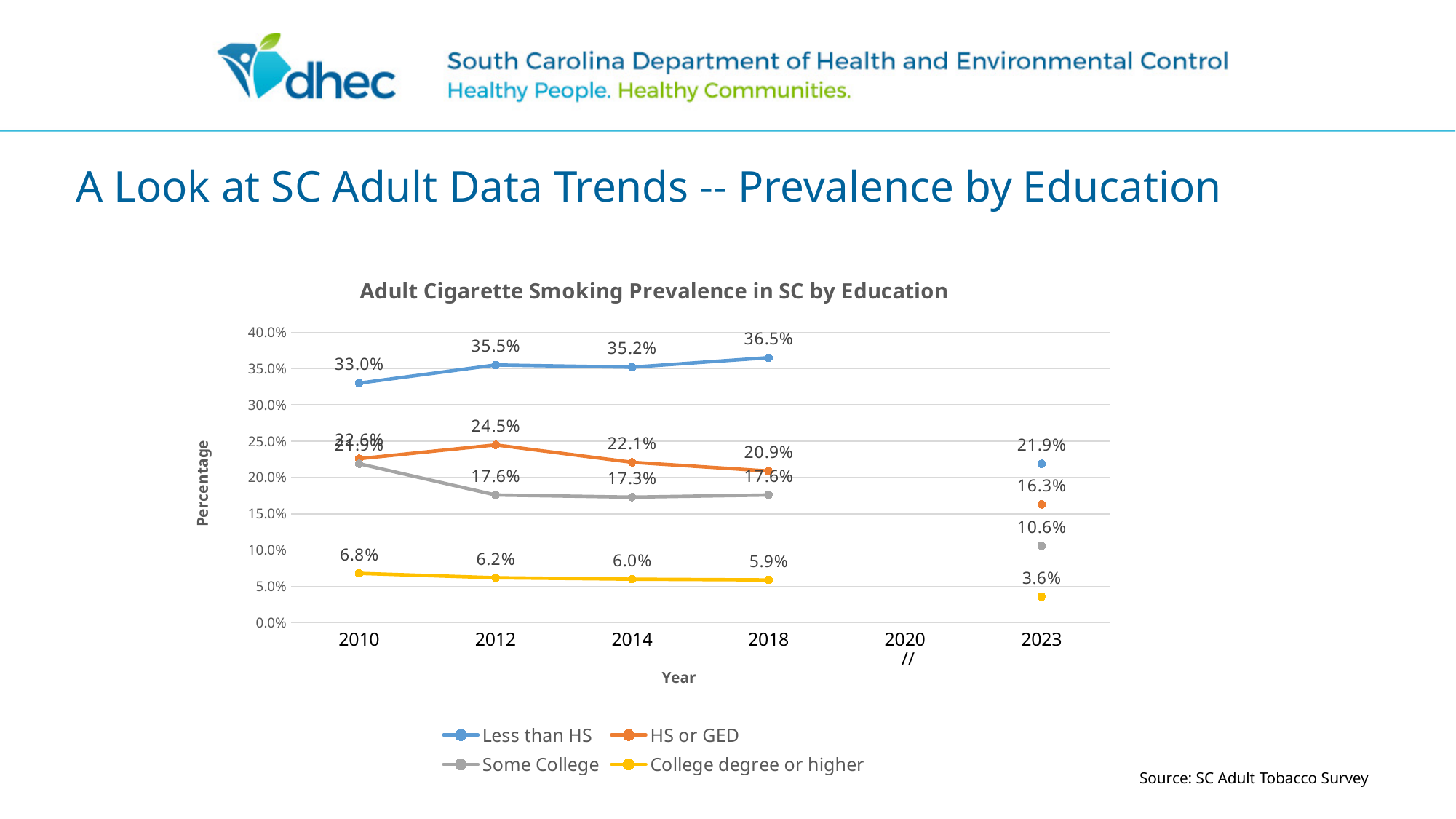
Which is larger in 2018: the HS or GED value or the Some College value? HS or GED Does the College degree or higher series rise or fall from 2010 to 2023? fall What was the smoking prevalence for College degree or higher in 2023? 3.6% In which year was the Less than HS prevalence highest? 2018 What type of chart is shown on the slide? line chart Which education group had the lowest smoking prevalence in 2023? College degree or higher What was the smoking prevalence for Less than HS in 2018? 36.5% What was the smoking prevalence for HS or GED in 2012? 24.5% What is the difference between the Less than HS and HS or GED values in 2023? 5.6% How many series does the legend list? 4 What is the title of the chart? Adult Cigarette Smoking Prevalence in SC by Education What was the smoking prevalence for Some College in 2014? 17.3%